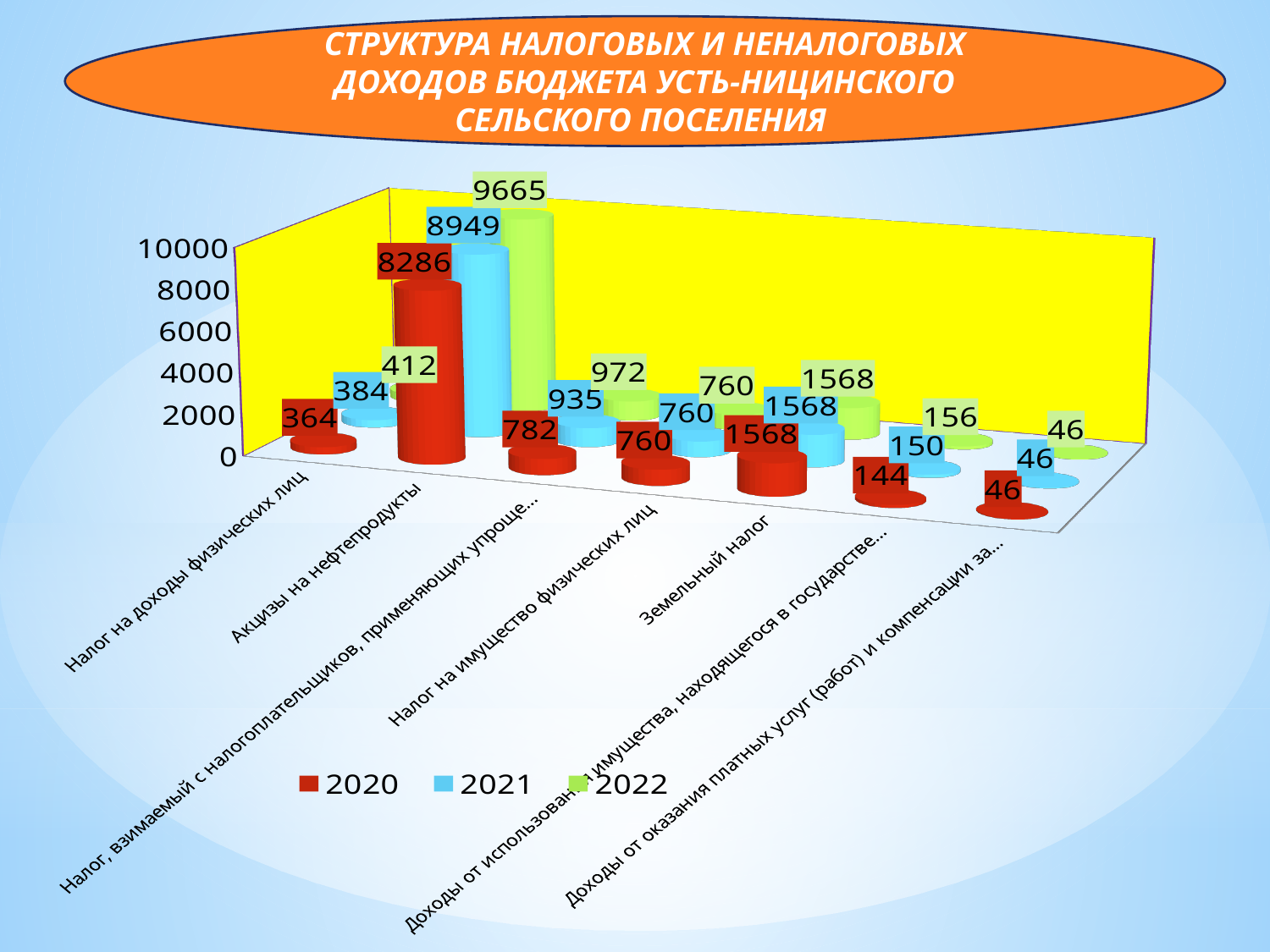
How many series does the legend list? 3 Which series is shown in green in the legend? 2022 What is the 2020 value for Акцизы на нефтепродукты? 8286 What kind of chart is shown on the slide? Bar chart How many categories are shown on the x axis? 7 What is the 2022 value for Налог на доходы физических лиц? 412 What is the difference between the 2022 and 2020 values for Акцизы на нефтепродукты? 1379 What is the 2022 value for Доходы от оказания платных услуг (работ) и компенсации за...? 46 Which category has the lowest 2020 value? Доходы от оказания платных услуг (работ) и компенсации за... What is the 2021 value for Земельный налог? 1568 Which category has the highest 2022 value? Акцизы на нефтепродукты Which is larger for Налог на доходы физических лиц: the 2021 value or the 2020 value? 2021